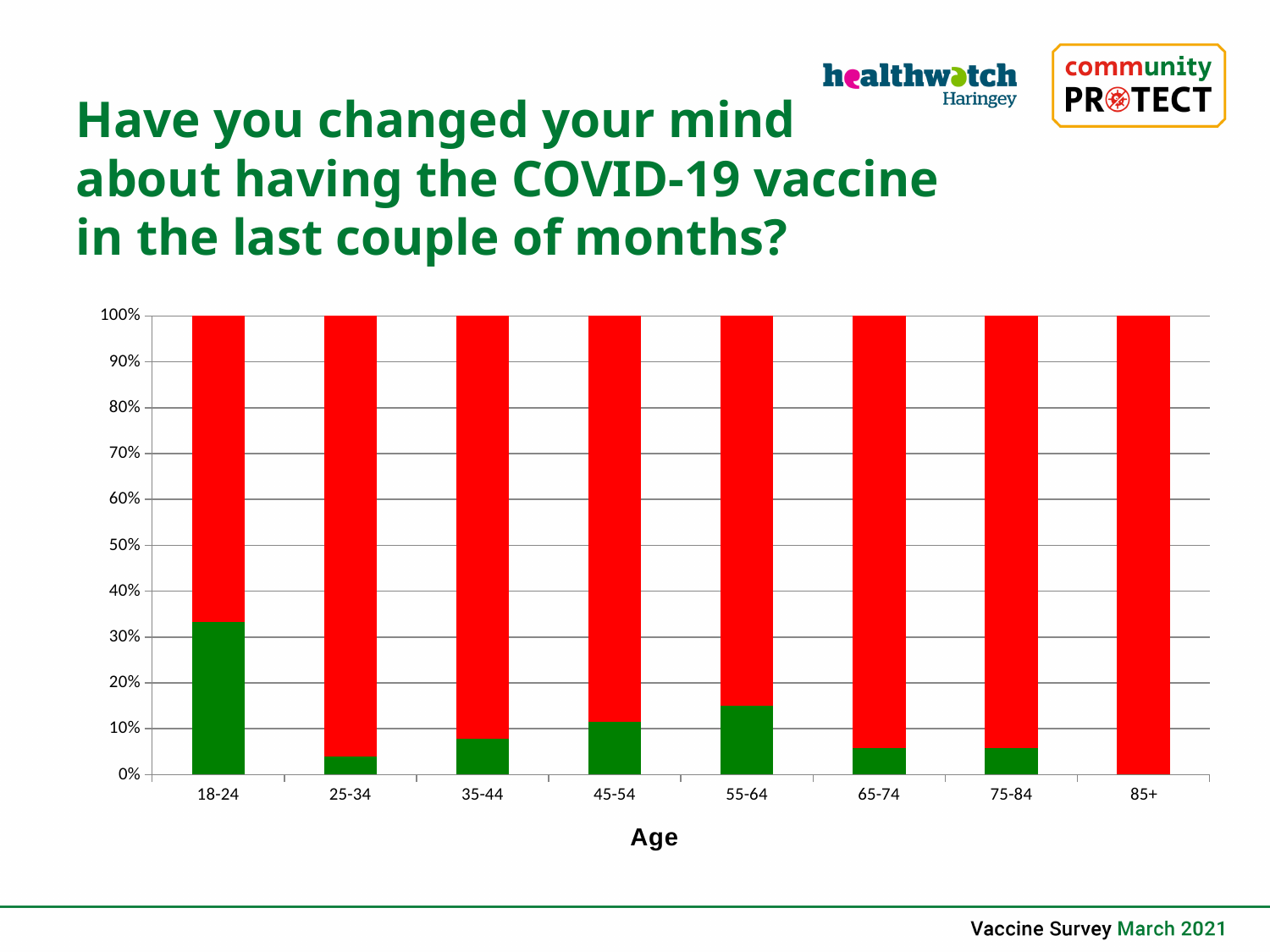
Which age group has no green segment at all? 85+ Which has the larger green segment, the 45-54 age group or the 25-34 age group? 45-54 What is the title of the x axis? Age How many age categories are shown on the x axis? 8 Which has the larger green segment, the 18-24 age group or the 55-64 age group? 18-24 Is the green segment for the 18-24 age group greater or less than 30%? greater What kind of chart is shown on the slide? stacked bar chart Is the green segment for the 55-64 age group greater or less than 20%? less Which age group has the largest green segment? 18-24 Is the green segment for the 25-34 age group greater or less than 10%? less What share of the 85+ bar is red? 100% What is the total height of the stacked bar for the 18-24 age group? 100%